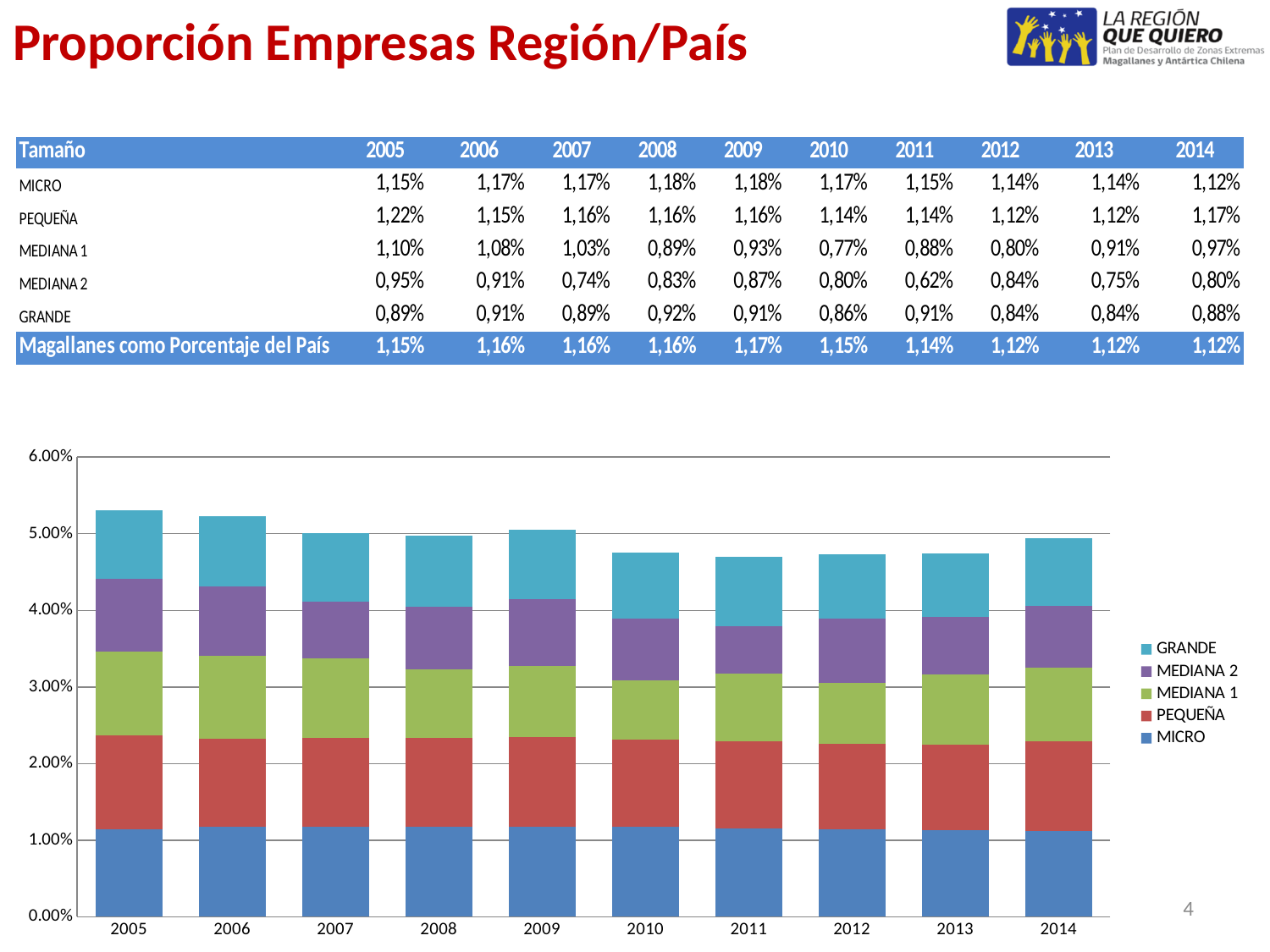
How many series does the chart legend list? 5 What is the difference between the PEQUEÑA value for 2005 and for 2014? 0,05% Which is larger, the MEDIANA 2 value for 2005 or for 2011? 2005 What kind of chart is shown on the slide? Stacked bar chart What is the MEDIANA 2 value for 2011? 0,62% What is the MICRO value for 2005? 1,15% What is the GRANDE value for 2014? 0,88% What is the total of the stacked bar for 2005? 5,30% Is the total stacked value for 2010 greater or less than 5.00%? less What is the total of the stacked bar for 2014? 4,94% How many years are plotted along the x axis of the chart? 10 Which year has the tallest stacked bar? 2005